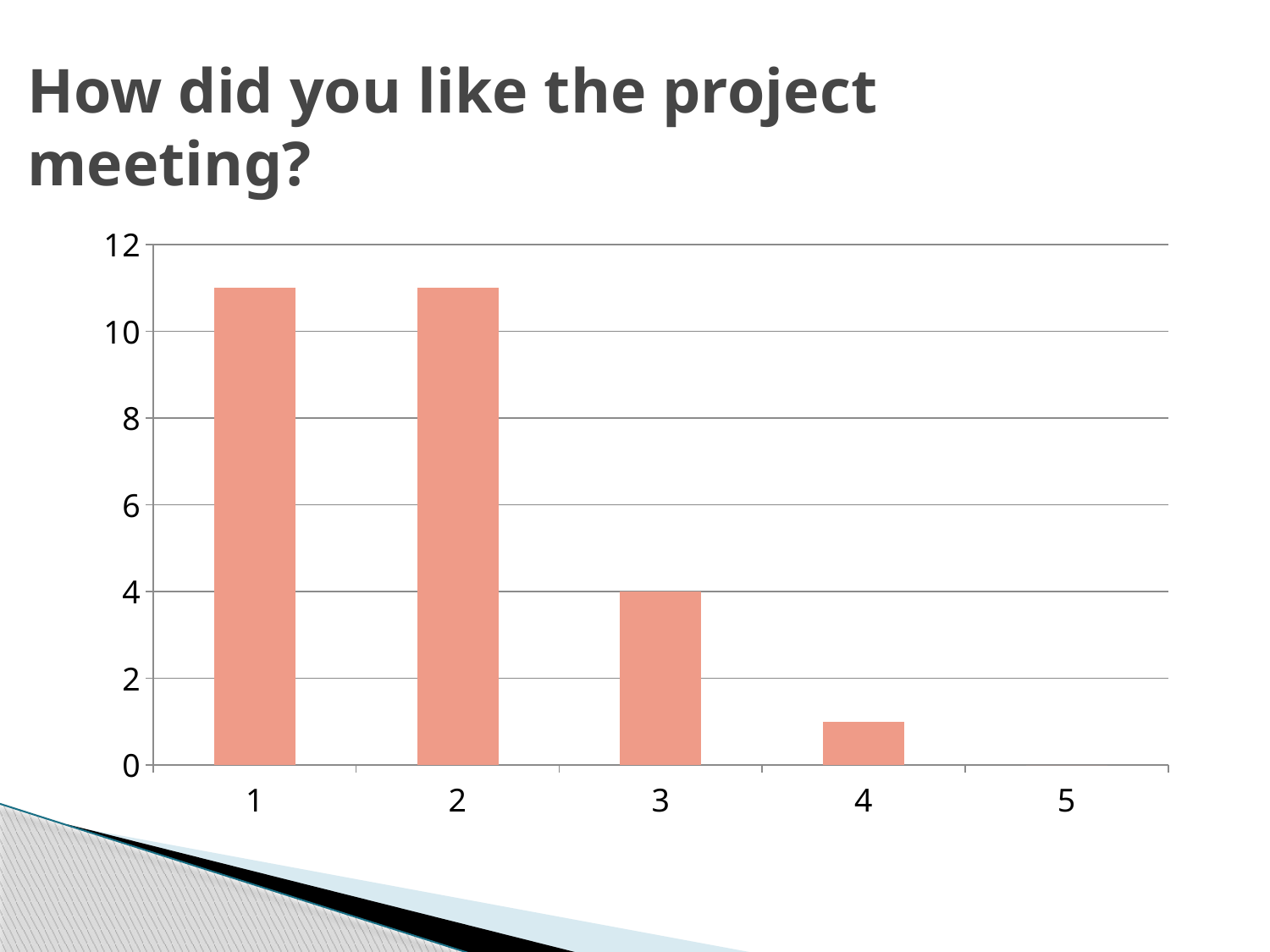
What colour are the bars in the chart? salmon (light orange-pink) What kind of chart is shown on the slide? bar chart What is the title of the chart on the slide? How did you like the project meeting? How many categories are shown on the x axis? 5 Which is larger, the value for category 1 or the value for category 3? category 1 What is the value for category 3? 4 Is the value for category 4 greater or less than 2? less Do the values rise or fall as you move from category 1 to category 5 along the x axis? fall Is the value for category 2 greater or less than 8? greater Which category has the lowest value? 5 Is the value for category 1 greater or less than 10? greater Which is larger, the value for category 4 or the value for category 2? category 2